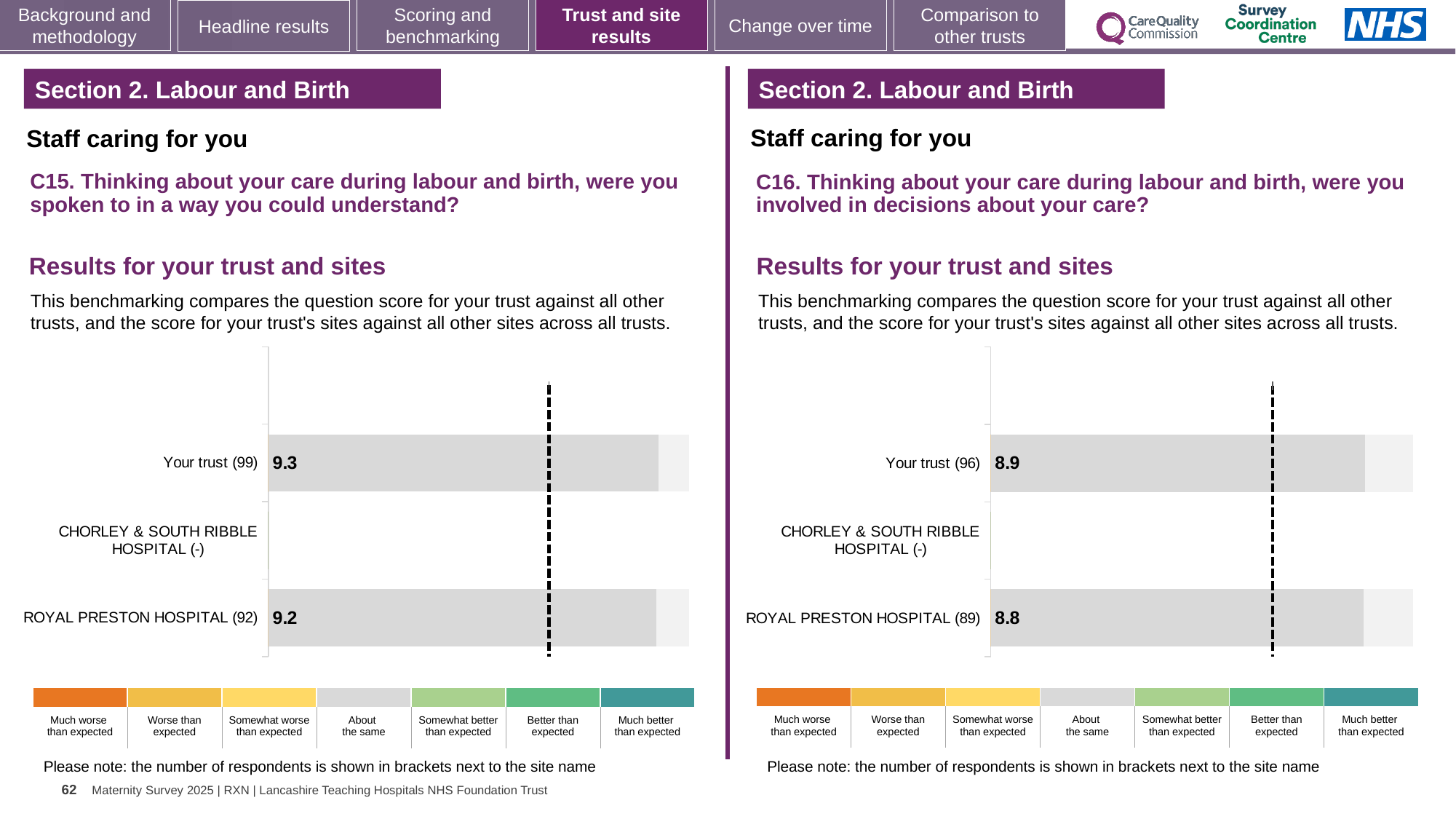
On the right chart (C16), what is the score for ROYAL PRESTON HOSPITAL? 8.8 On the right chart (C16), which has the higher score, Your trust or ROYAL PRESTON HOSPITAL? Your trust On the right chart (C16), what is the difference between the score for Your trust and the score for ROYAL PRESTON HOSPITAL? 0.1 How many categories are listed on the left chart (C15)? 3 On the left chart (C15), what is the score for ROYAL PRESTON HOSPITAL? 9.2 On the right chart (C16), what is the score for Your trust? 8.9 On the left chart (C15), how many respondents are shown in brackets for Your trust? 99 On the left chart (C15), what is the score for Your trust? 9.3 On the right chart (C16), how many respondents are shown in brackets for ROYAL PRESTON HOSPITAL? 89 On the left chart (C15), what is the difference between the score for Your trust and the score for ROYAL PRESTON HOSPITAL? 0.1 On the left chart (C15), which has the higher score, Your trust or ROYAL PRESTON HOSPITAL? Your trust What kind of chart is used on the right (C16)? Bar chart